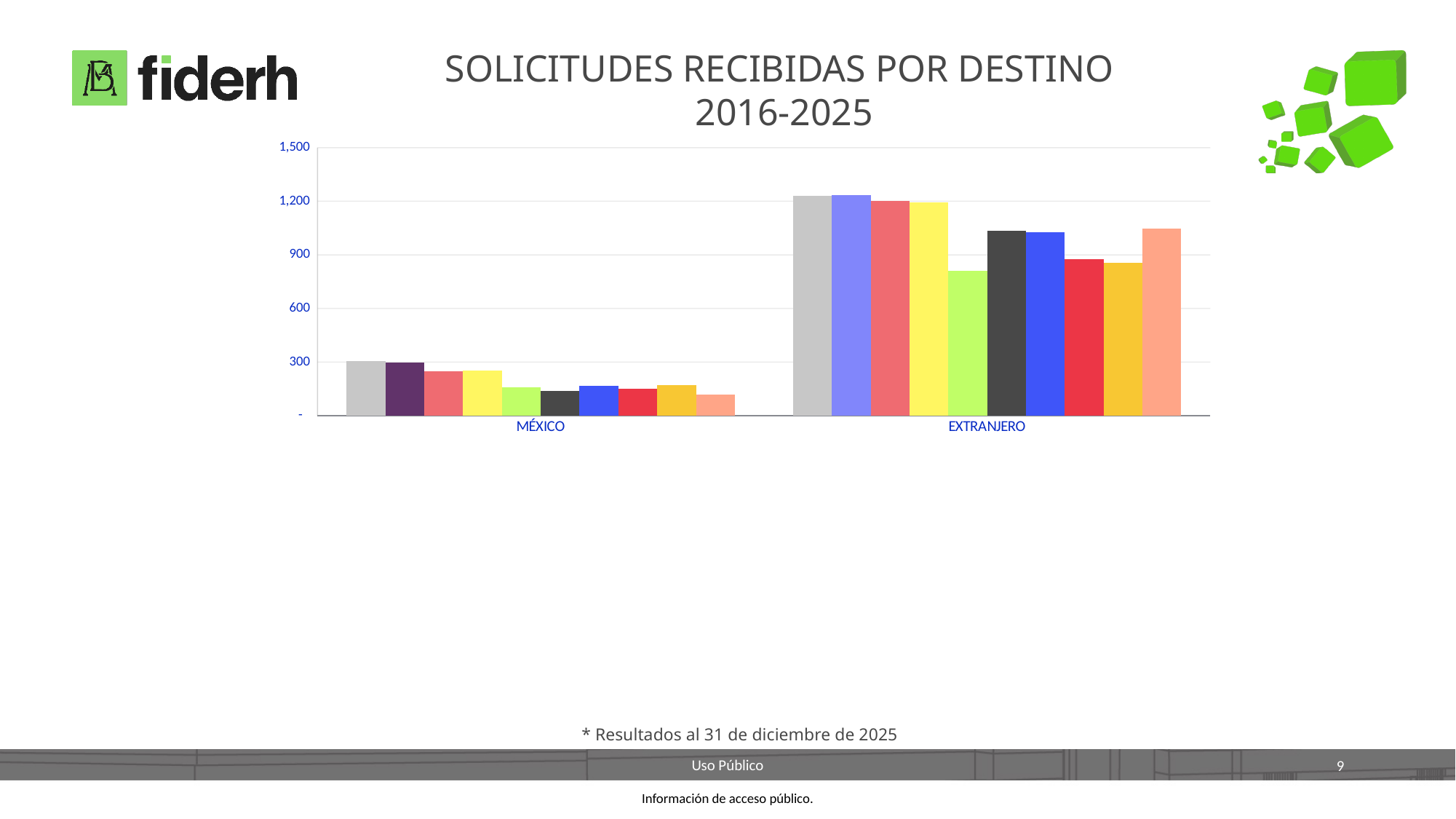
What is the highest value shown on the vertical axis of the chart? 1,500 Is the value of the light green bar for EXTRANJERO greater or less than 900? less Which category has the taller bars overall, MÉXICO or EXTRANJERO? EXTRANJERO Is the value of the first (grey) bar for EXTRANJERO greater or less than 900? greater Is the value of the last (light orange) bar for MÉXICO greater or less than 300? less How many bars are plotted for the MÉXICO category? 10 Within the EXTRANJERO category, is the light green bar higher or lower than the yellow bar next to it? lower How many categories are shown on the x axis of the chart? 2 What are the two categories on the x axis of the chart? MÉXICO and EXTRANJERO What kind of chart is shown on the slide? bar chart